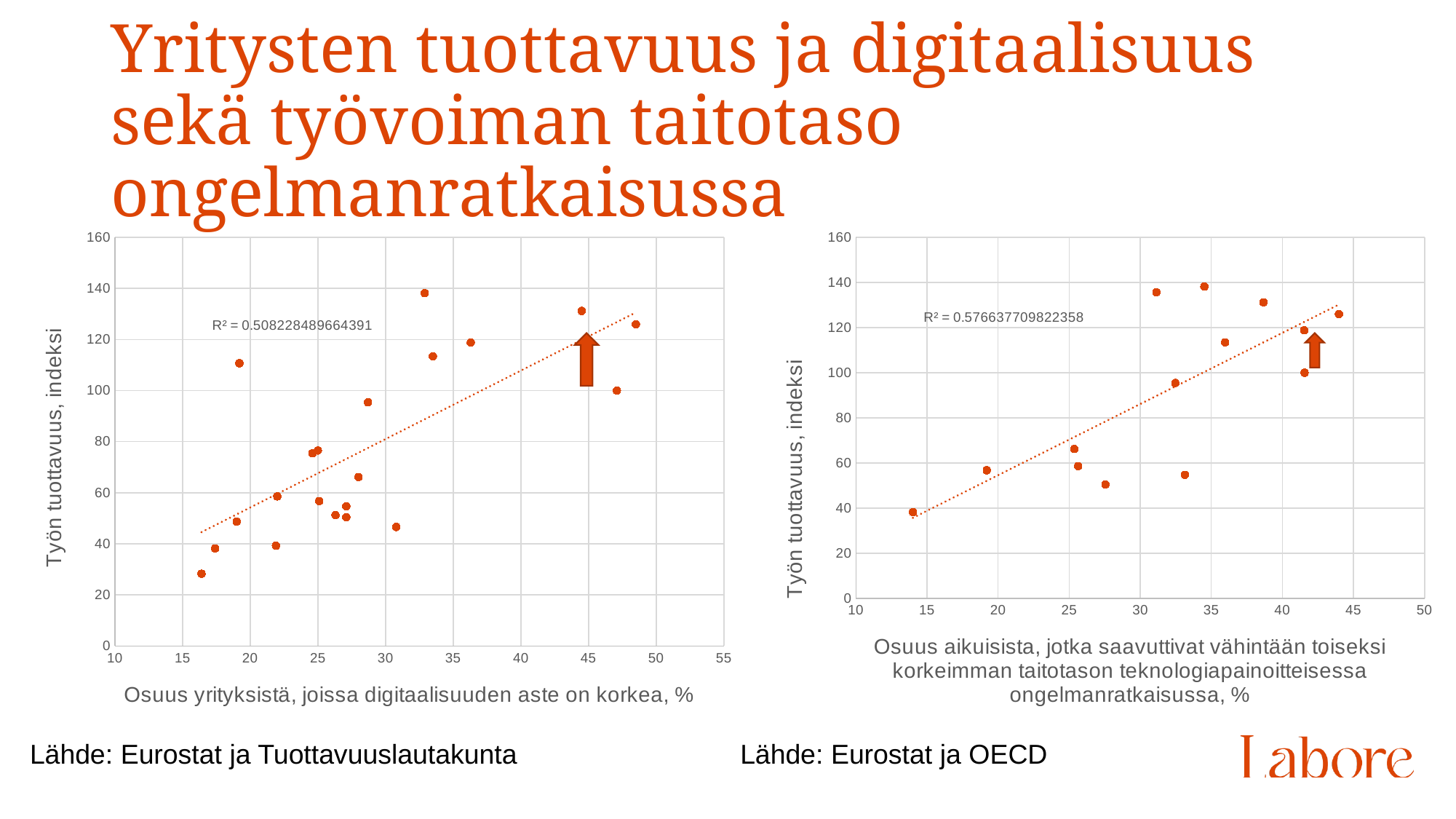
In the right chart, what R² value is printed for the trend line? R² = 0.576637709822358 Which chart has the larger printed R² value, the left chart or the right chart? the right chart In the right chart, is the y value of the lowest point greater or less than 60? less What is the highest tick value shown on the y axis of the right chart? 160 In the left chart, is the y value of the lowest point greater or less than 40? less What is the y-axis label of the left chart? Työn tuottavuus, indeksi In the left chart, is the y value of the highest point greater or less than 120? greater What kind of chart is the right chart, with x axis 'Osuus aikuisista, jotka saavuttivat vähintään toiseksi korkeimman taitotason teknologiapainoitteisessa ongelmanratkaisussa, %'? scatter chart In the left chart, what R² value is printed for the trend line? R² = 0.508228489664391 In the left chart, does labour productivity (Työn tuottavuus, indeksi) tend to rise or fall as the share of highly digital firms increases along the x axis? rise In the right chart, does labour productivity tend to rise or fall as the share of adults with high problem-solving skills increases along the x axis? rise What kind of chart is the left chart, with x axis 'Osuus yrityksistä, joissa digitaalisuuden aste on korkea, %'? scatter chart